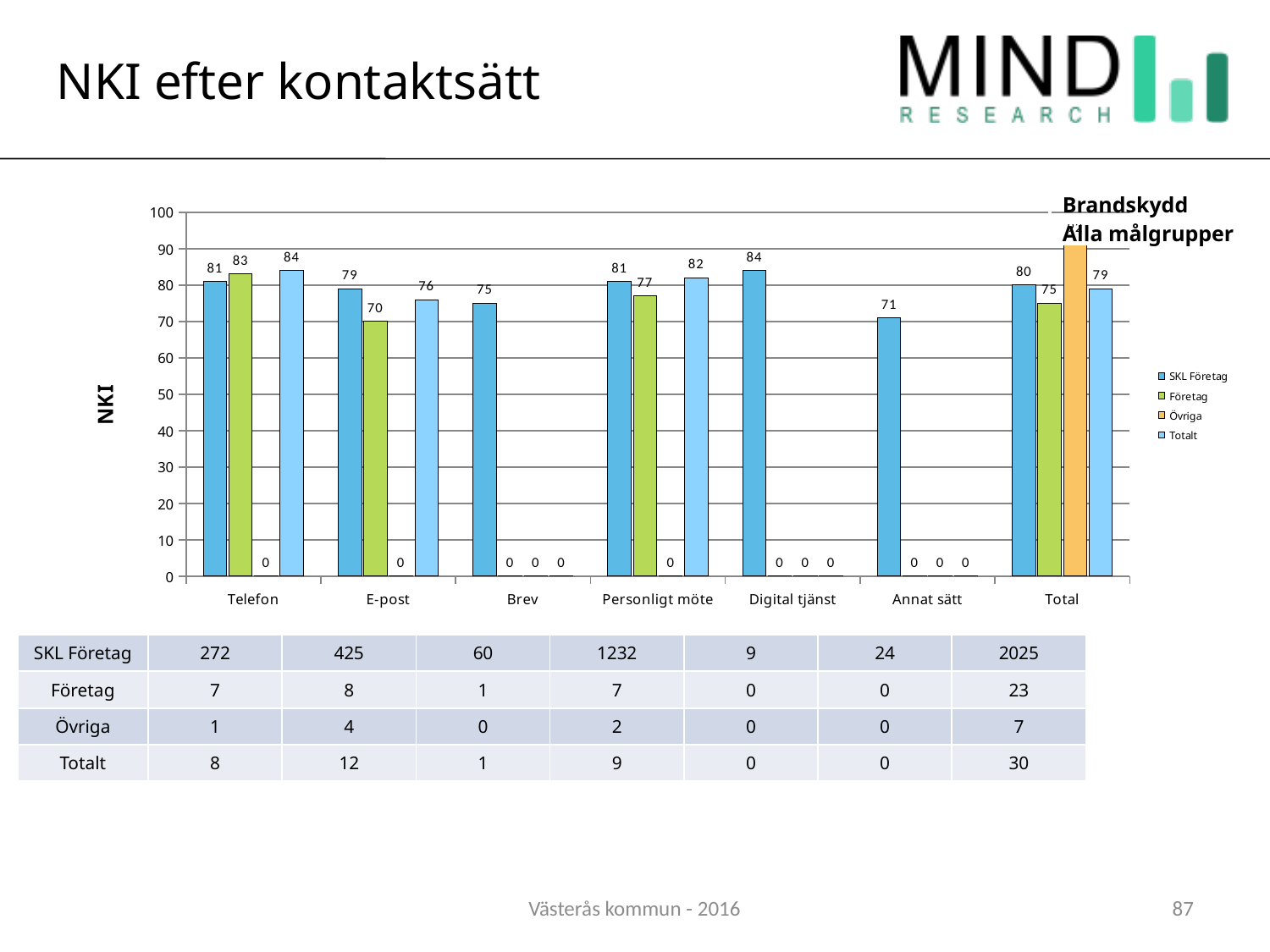
What is the Företag value for E-post? 70 What is the label on the vertical axis of the chart? NKI What kind of chart is shown on the slide? Bar chart What is the SKL Företag value for Brev? 75 What is the NKI value for SKL Företag in the Telefon category? 81 How many series does the legend list? 4 What is the Totalt value for Personligt möte? 82 Which contact method has the lowest SKL Företag value? Annat sätt Which is larger: the Företag value for Telefon or the Företag value for Personligt möte? Telefon Which contact method has the highest SKL Företag value? Digital tjänst What is the difference between the Totalt value for Telefon and the Totalt value for E-post? 8 How many categories are shown on the x axis of the chart? 7